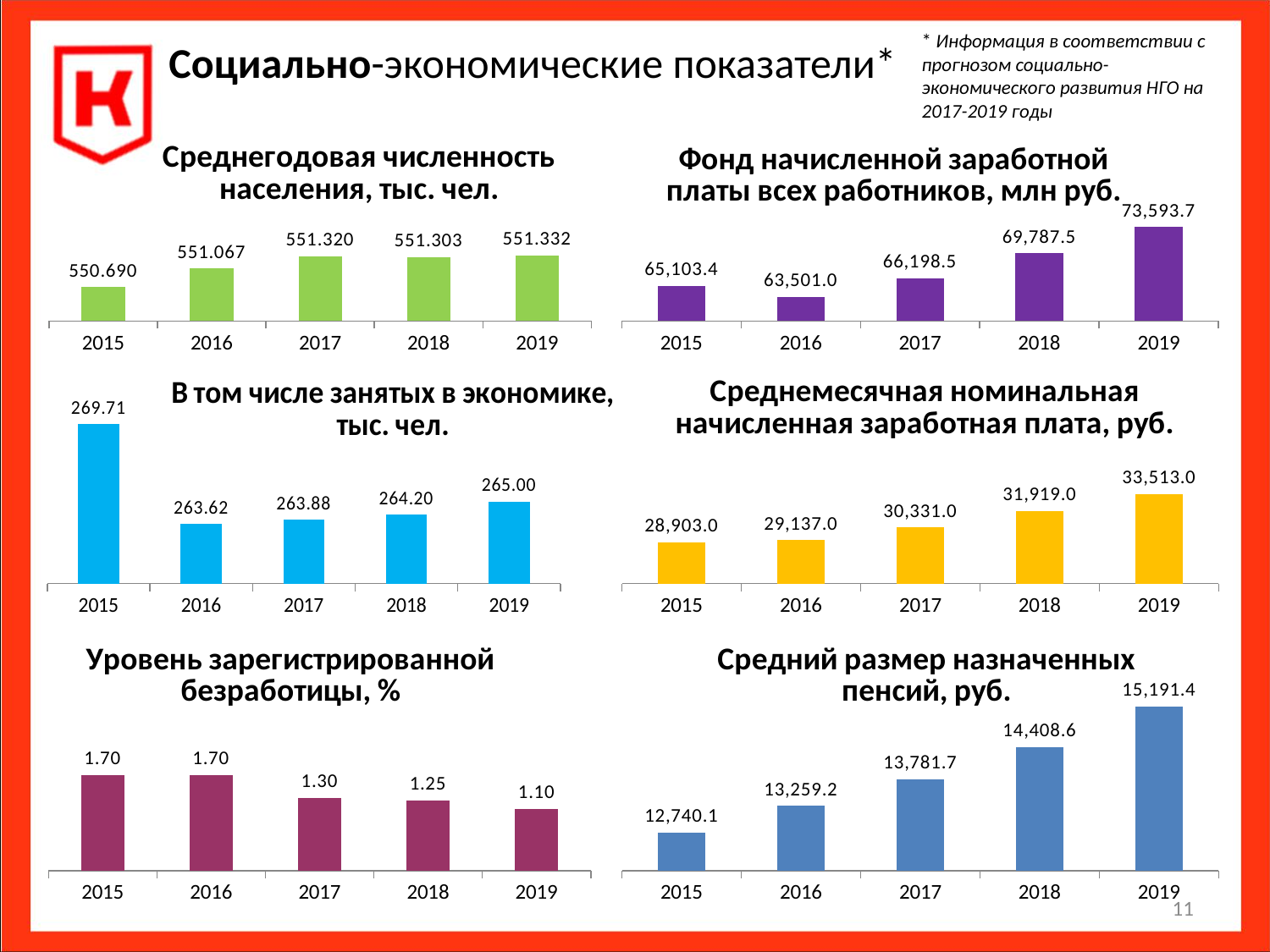
In the chart 'В том числе занятых в экономике, тыс. чел.', what is the value for 2018? 264.20 In the chart 'В том числе занятых в экономике, тыс. чел.', which year has the highest value? 2015 In the chart 'Среднемесячная номинальная начисленная заработная плата, руб.', do the values rise or fall from 2015 to 2019? rise In the chart 'Уровень зарегистрированной безработицы, %', what is the value for 2019? 1.10 In the chart 'Средний размер назначенных пенсий, руб.', how many years are shown on the x axis? 5 How many charts are shown on the slide? 6 In the chart 'Фонд начисленной заработной платы всех работников, млн руб.', what is the difference between the 2019 and 2018 values? 3,806.2 In the chart 'Фонд начисленной заработной платы всех работников, млн руб.', which year has the lowest value? 2016 In the chart 'Уровень зарегистрированной безработицы, %', which is larger, the value for 2017 or the value for 2018? 2017 In the chart 'Среднемесячная номинальная начисленная заработная плата, руб.', what is the difference between the 2019 and 2015 values? 4,610.0 In the chart 'Среднегодовая численность населения, тыс. чел.', what is the value for 2017? 551.320 In the chart 'Средний размер назначенных пенсий, руб.', what is the value for 2016? 13,259.2